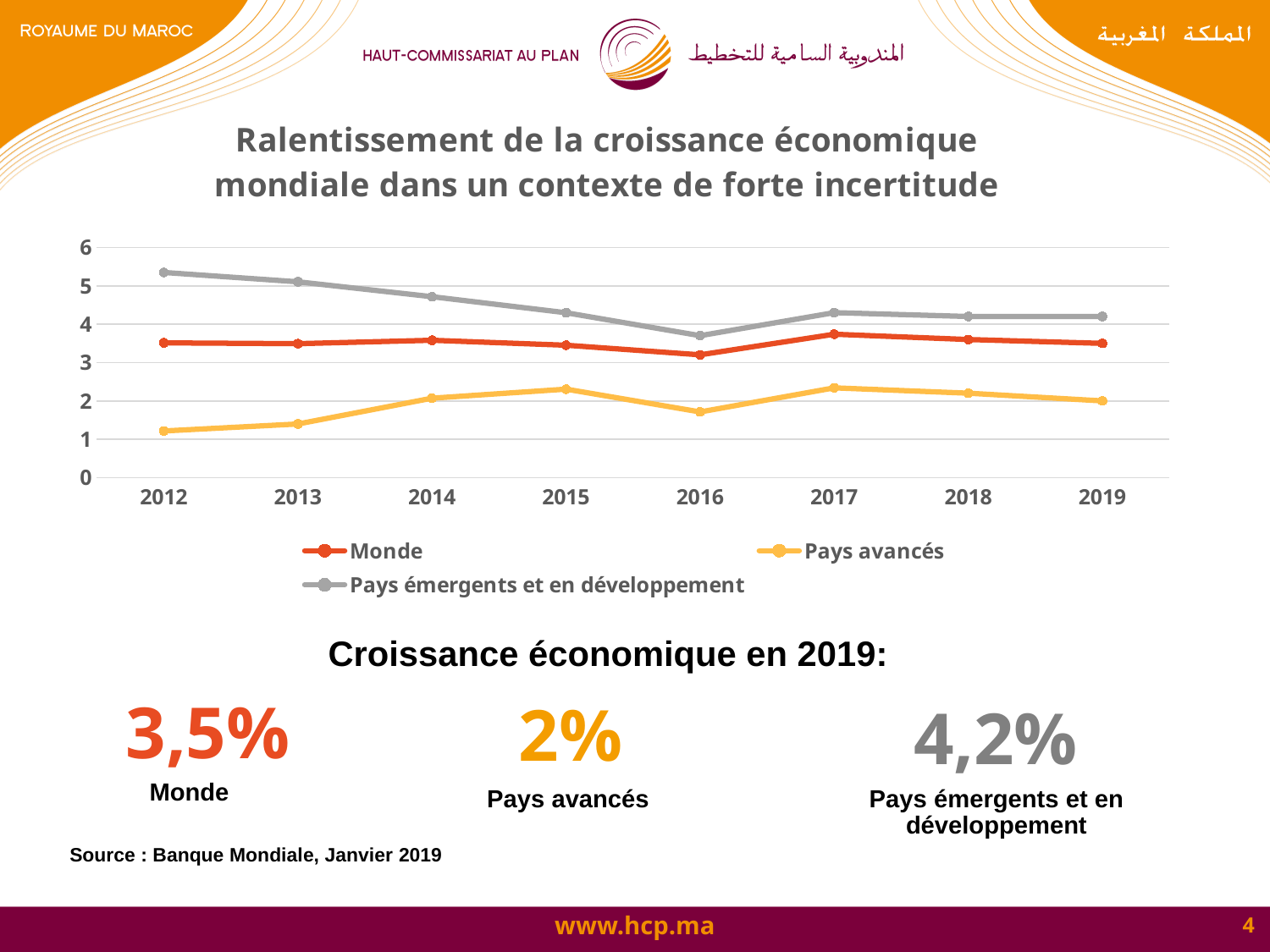
Does the Pays émergents et en développement line rise or fall from 2012 to 2016? Fall What is the economic growth value for Monde in 2019? 3,5% In 2019, which is larger: the growth of Monde or of Pays avancés? Monde In which year is the value for Pays émergents et en développement the lowest? 2016 Is the value for Pays émergents et en développement in 2012 greater or less than 5? greater What is the economic growth value for Pays émergents et en développement in 2019? 4,2% What kind of chart is shown on the slide? Line chart What is the economic growth value for Pays avancés in 2019? 2% In 2019, what is the difference between the growth of Pays émergents et en développement and Monde? 0,7 Is the value for Pays avancés in 2012 greater or less than 2? less How many years are plotted along the x axis of the chart? 8 How many series does the chart legend list? 3